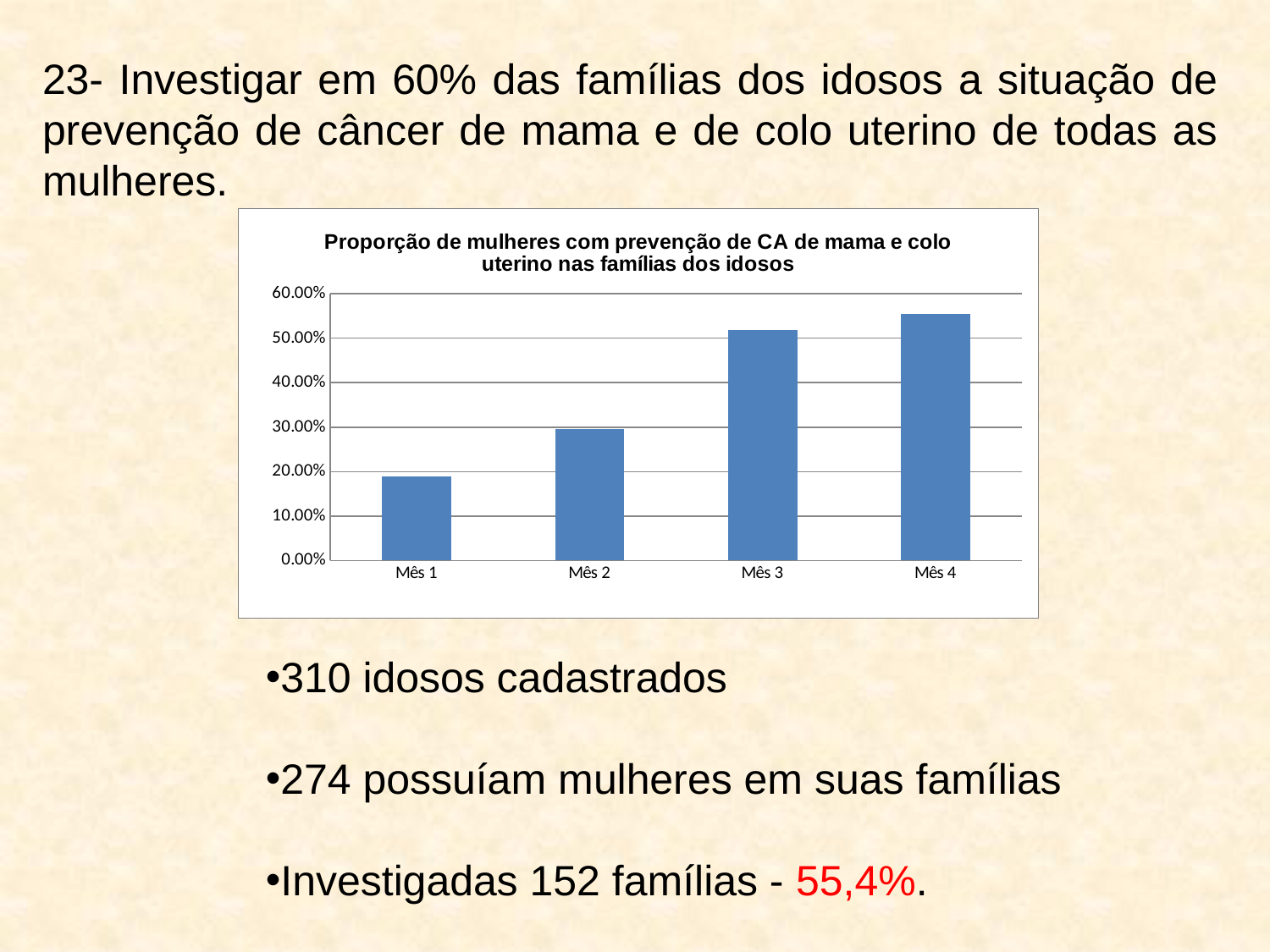
Which is larger, the value for Mês 2 or the value for Mês 3? Mês 3 Do the values in the chart rise or fall from Mês 1 to Mês 4? rise Which month has the highest proportion in the chart? Mês 4 Is the value for Mês 4 greater or less than 60.00%? less How many months (categories) are shown on the x axis of the chart? 4 What is the title of the chart? Proporção de mulheres com prevenção de CA de mama e colo uterino nas famílias dos idosos Is the value for Mês 1 greater or less than 20.00%? less Is the value for Mês 2 greater or less than 20.00%? greater What kind of chart is shown on the slide? bar chart What is the highest value shown on the y axis of the chart? 60.00% Which month has the lowest proportion in the chart? Mês 1